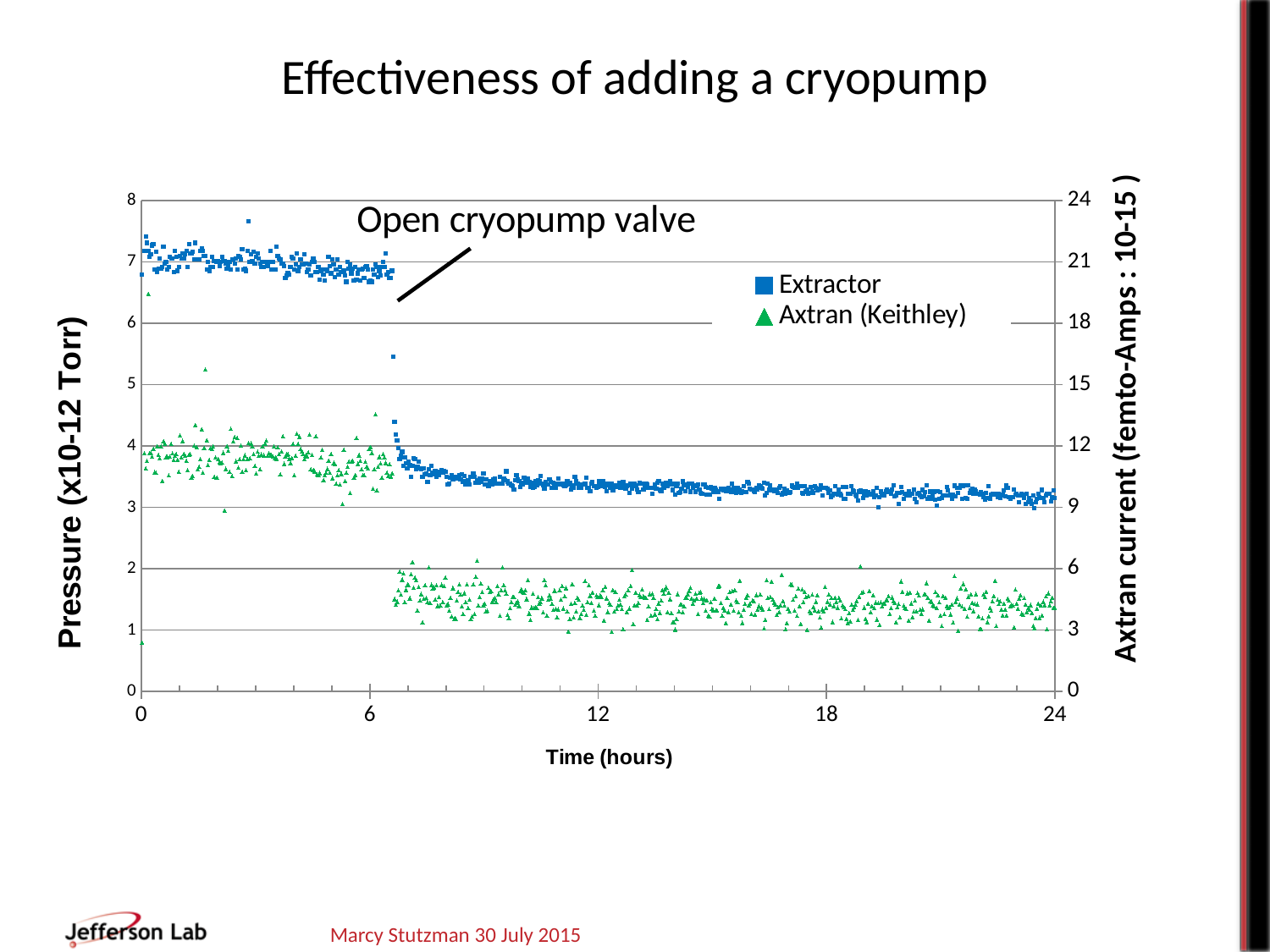
What are the two series named in the legend? Extractor and Axtran (Keithley) How many series does the legend list? 2 Is the Axtran (Keithley) current at 12 hours greater or less than 6 on the right axis? less Is the Axtran (Keithley) current at 2 hours greater or less than 9 on the right axis? greater What is the maximum value shown on the x axis? 24 Is the Extractor pressure at 2 hours greater or less than 6 on the left axis? greater What is the title of the chart? Effectiveness of adding a cryopump What kind of chart is shown on the slide? scatter chart Do the Extractor values rise or fall over the 24 hours shown? fall Which series has the higher value on the left axis scale at 18 hours, Extractor or Axtran (Keithley)? Extractor